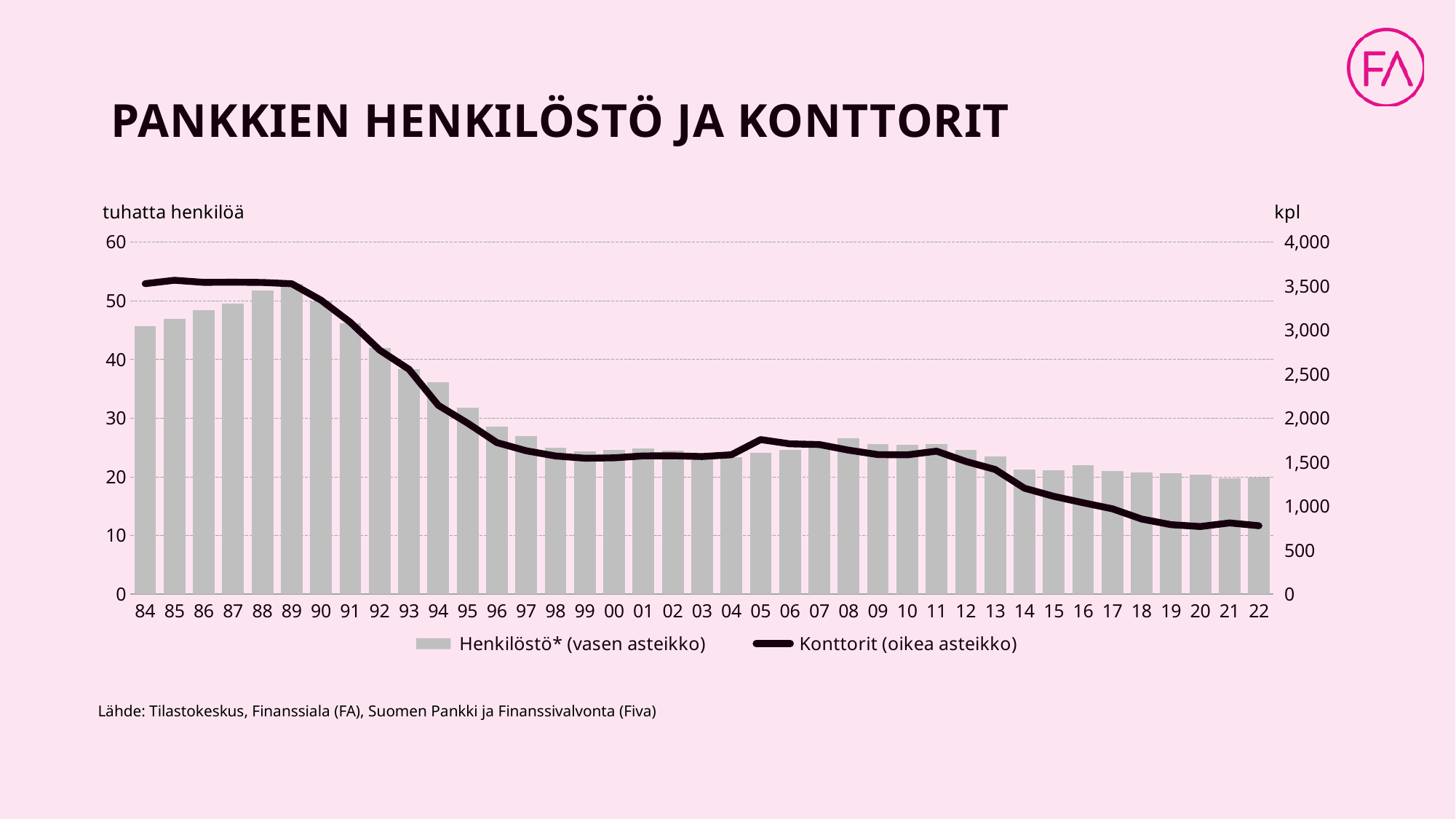
Is the Konttorit value for 05 greater or less than 1,500? greater Is the Konttorit value for 89 greater or less than 3,000? greater Is the Henkilöstö value for 84 greater or less than 40? greater Does the Konttorit line overall rise or fall from 84 to 22? fall How many years are plotted along the x axis? 39 What kind of chart is shown on the slide? A combined bar and line chart What unit is shown on the left axis? tuhatta henkilöä How many series does the legend list? 2 Which is larger, the Henkilöstö value for 88 or for 95? 88